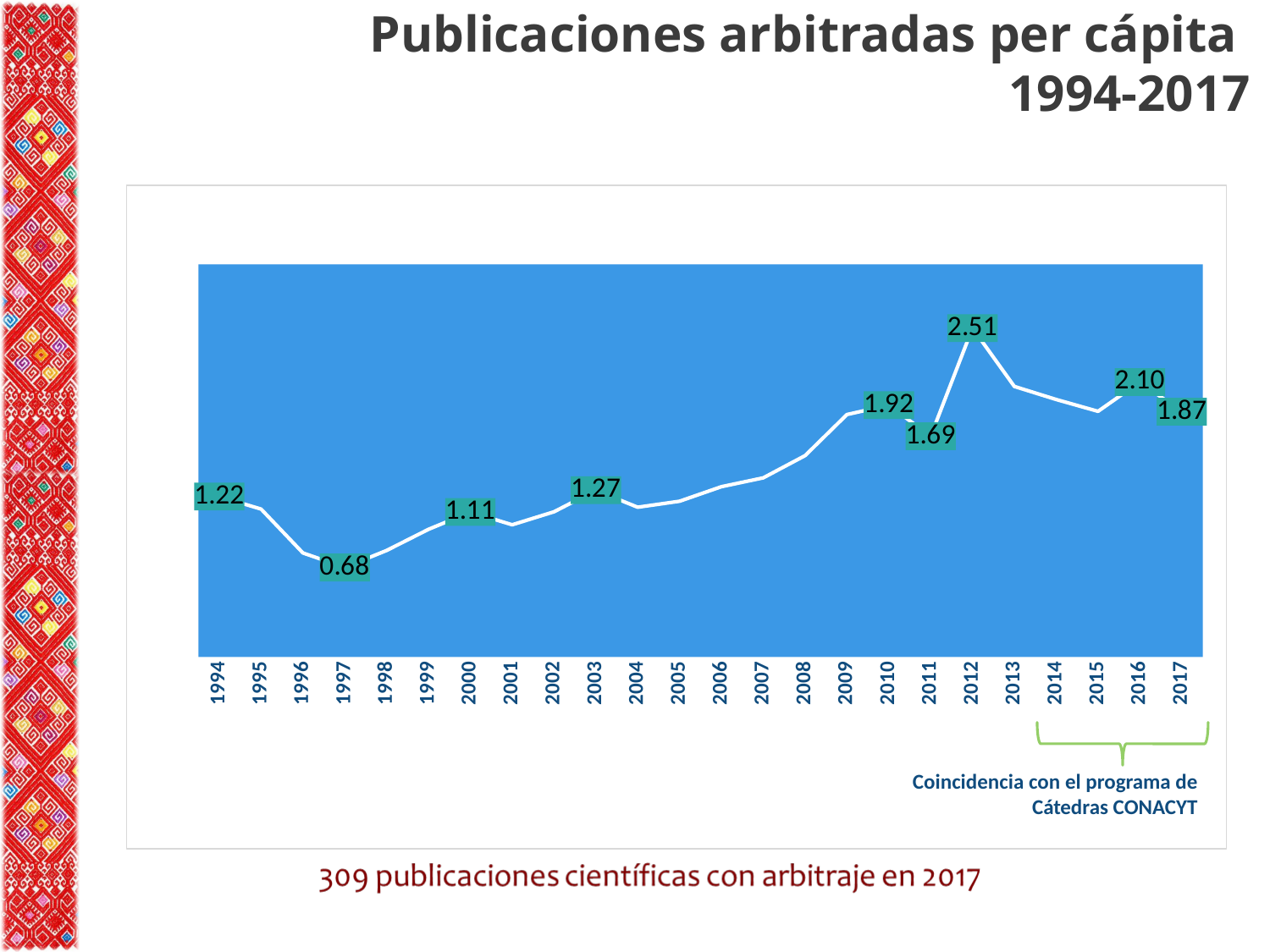
Which year has the highest value? 2012 What is the difference between the values for 2012 and 2011? 0.82 What is the lowest value labeled on the chart? 0.68 Do the values rise or fall from 2003 to 2010? rise What is the difference between the values for 2016 and 2017? 0.23 Which is larger, the value for 2010 or the value for 2011? 2010 What is the value for 2017? 1.87 How many years are shown on the x axis? 24 What is the value for 2003? 1.27 What is the value for 2012? 2.51 What is the value for 1994? 1.22 What kind of chart is shown on the slide? line chart